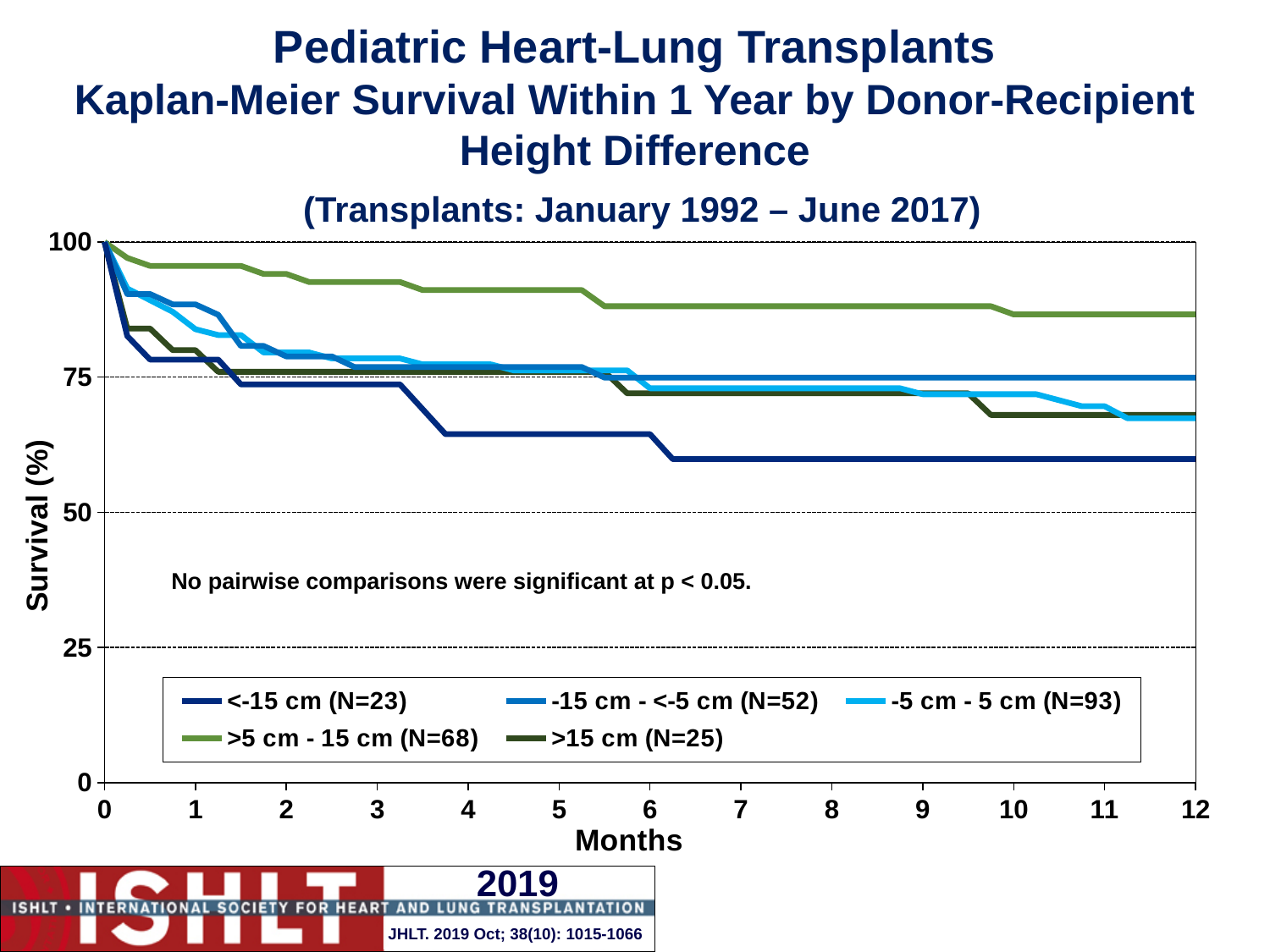
Which series has the highest survival at 12 months? >5 cm - 15 cm (N=68) How many series does the legend list? 5 What is the label of the y axis? Survival (%) Is the survival for the <-15 cm group at 12 months greater or less than 50? greater Which is higher at 12 months: the survival for the >5 cm - 15 cm group or the <-15 cm group? >5 cm - 15 cm Which series has the lowest survival at 12 months? <-15 cm (N=23) Is the survival for the <-15 cm group at 12 months greater or less than 75? less Is the survival for the >5 cm - 15 cm group at 12 months greater or less than 75? greater Do the survival curves rise or fall as months increase? fall What is the survival value for all groups at month 0? 100 What kind of chart is shown on the slide? line chart